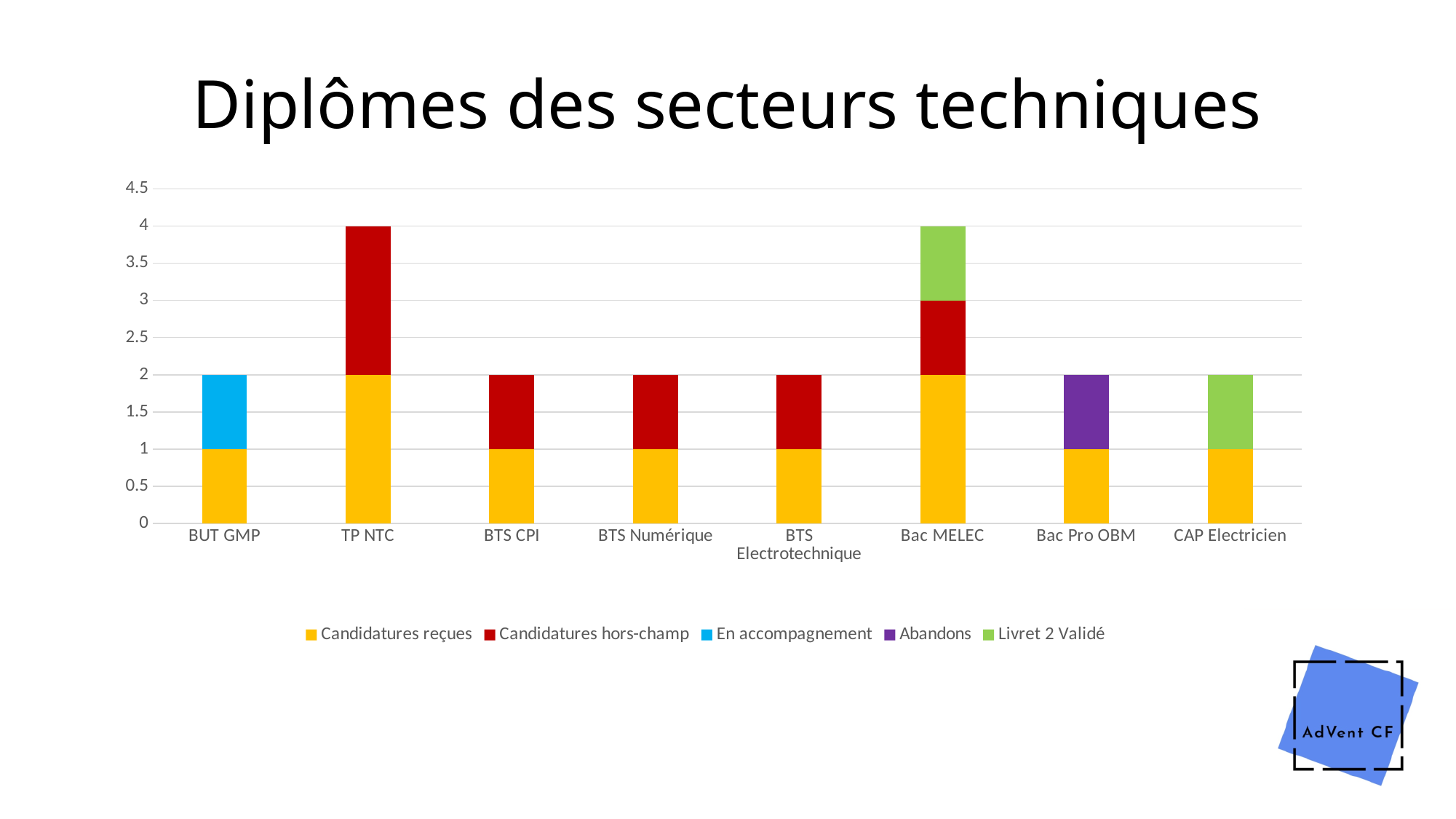
What is the total height of the stacked bar for BUT GMP? 2 How many diploma categories are shown on the x axis? 8 What kind of chart is shown on the slide? Stacked bar chart Which is larger, the total for TP NTC or the total for BTS CPI? TP NTC What is the value of Candidatures reçues for TP NTC? 2 What is the total height of the stacked bar for Bac MELEC? 4 What is the title of the chart? Diplômes des secteurs techniques What is the value of Candidatures hors-champ for TP NTC? 2 What is the value of Abandons for Bac Pro OBM? 1 What is the value of Livret 2 Validé for CAP Electricien? 1 What is the difference between the total for Bac MELEC and the total for Bac Pro OBM? 2 How many series does the legend list? 5